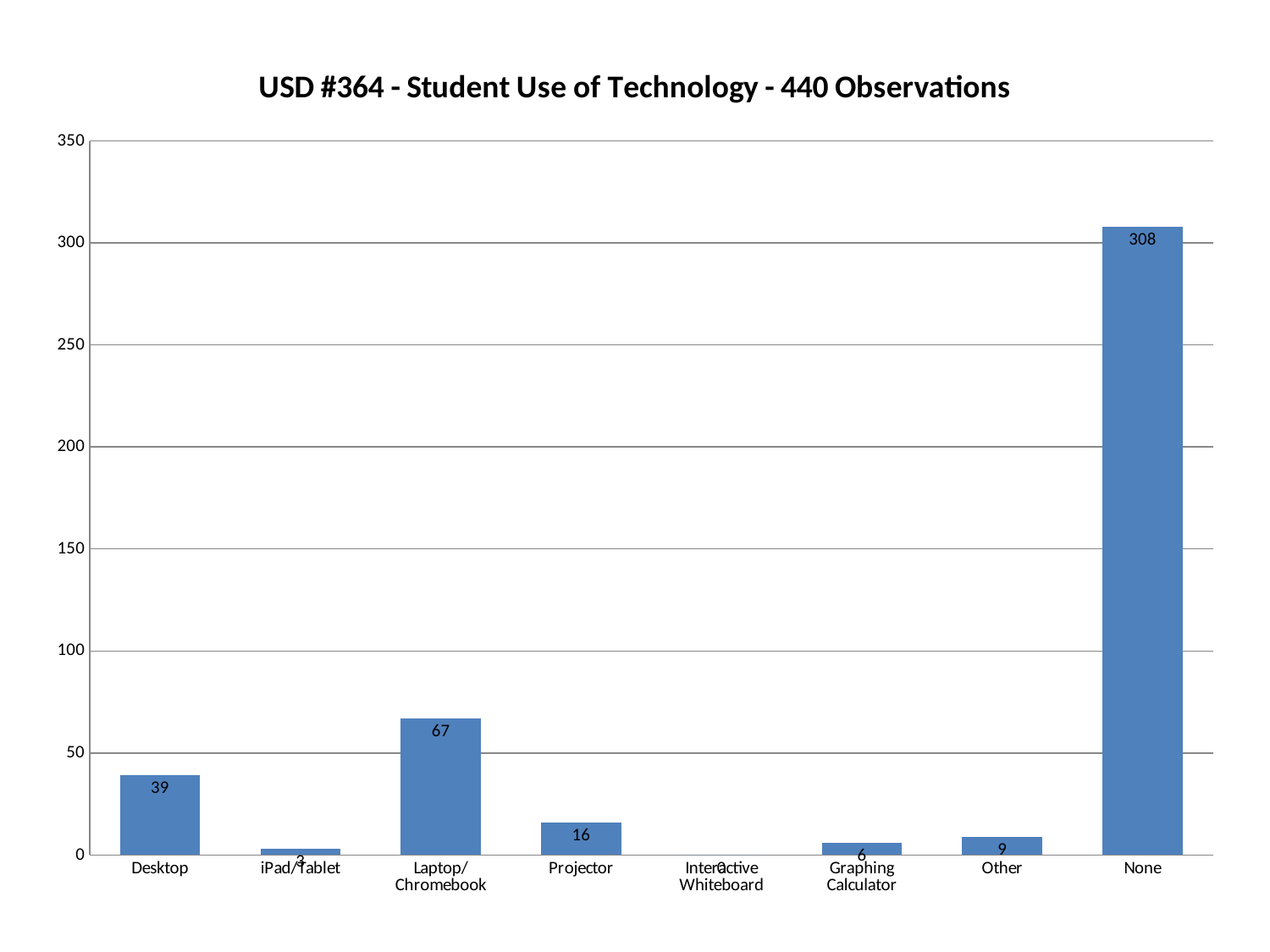
Which is larger, the value for Projector or the value for Other? Projector What is the value for Projector? 16 What is the value for Laptop/Chromebook? 67 What is the title of the chart? USD #364 - Student Use of Technology - 440 Observations What is the value for None? 308 How many categories are shown on the x axis? 8 What is the value for Desktop? 39 What is the difference between the values for Laptop/Chromebook and Desktop? 28 What is the value for Other? 9 Which category has the lowest value? Interactive Whiteboard Which category has the highest value? None Is the value for None greater or less than 300? greater